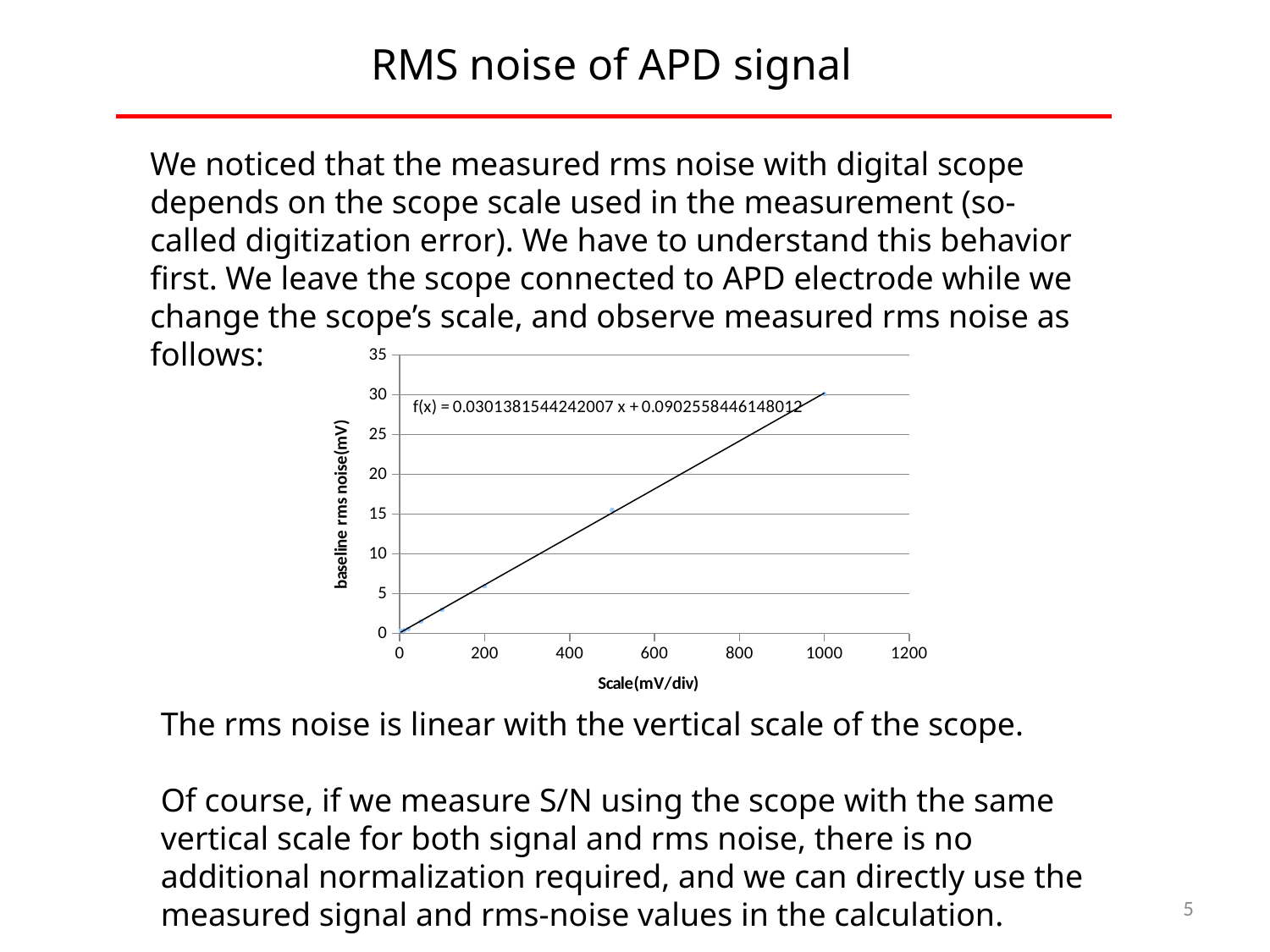
Does the baseline rms noise rise or fall as the scale (mV/div) increases? rise Which has the larger baseline rms noise: the point at 500 mV/div or the point at 200 mV/div? 500 mV/div Is the baseline rms noise at a scale of 200 mV/div greater or less than 10? less Which scale setting has the highest baseline rms noise? 1000 mV/div Is the baseline rms noise at a scale of 500 mV/div greater or less than 10? greater What is the label of the x axis? Scale(mV/div) Is the baseline rms noise at a scale of 1000 mV/div greater or less than 25? greater What kind of chart is shown on the slide? scatter chart What is the label of the y axis? baseline rms noise(mV)